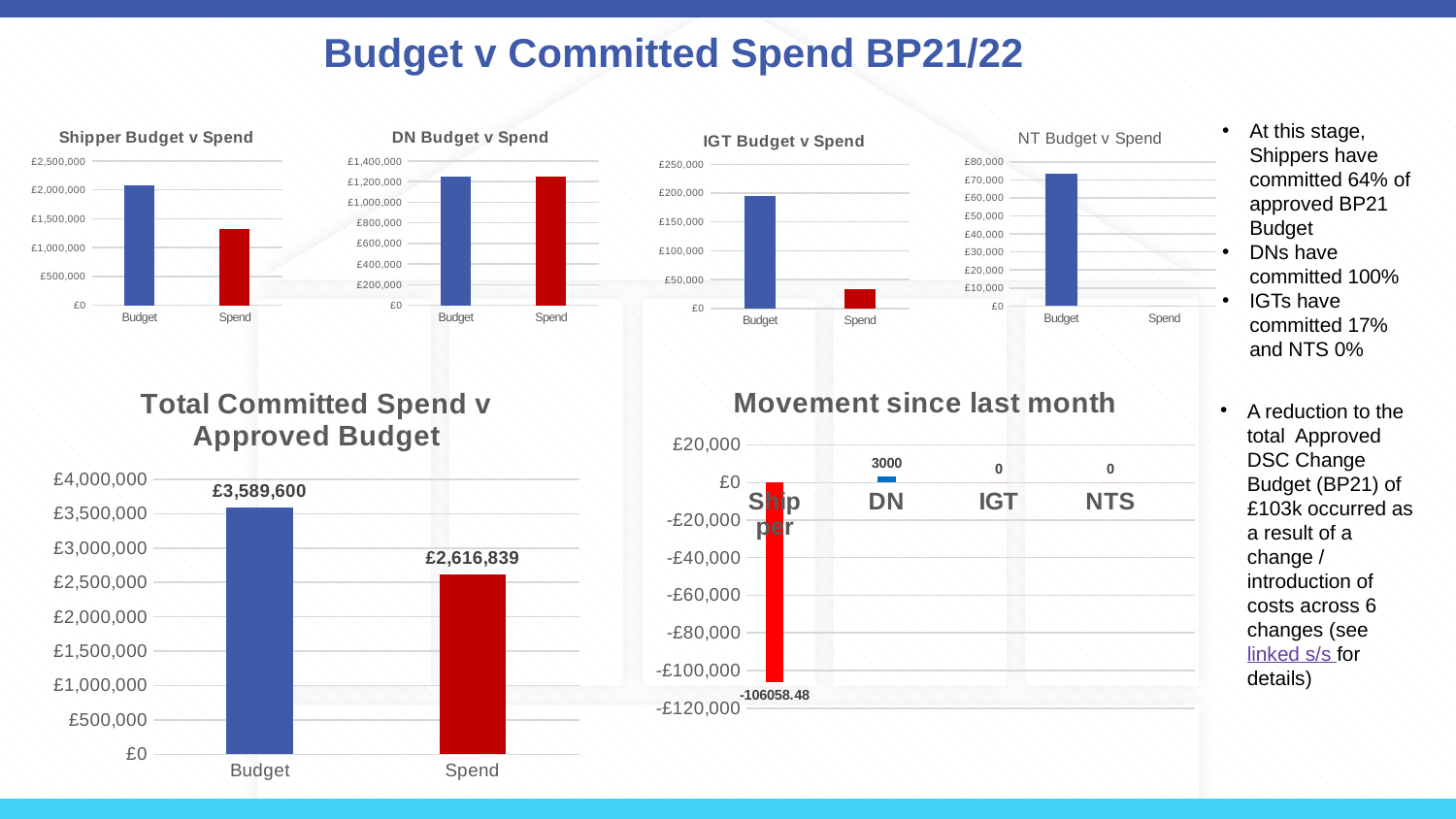
In the 'Movement since last month' chart, how many categories are shown on the x axis? 4 In the 'Movement since last month' chart, what is the value for Shipper? -106058.48 In the 'Total Committed Spend v Approved Budget' chart, what is the difference between Budget and Spend? £972,761 In the 'IGT Budget v Spend' chart, is the value for Spend greater or less than £50,000? less In the 'Movement since last month' chart, which category has the lowest value? Shipper In the 'Total Committed Spend v Approved Budget' chart, what is the value for Spend? £2,616,839 In the 'Shipper Budget v Spend' chart, is the value for Budget greater or less than £1,500,000? greater In the 'Movement since last month' chart, what is the value for DN? 3000 In the 'NT Budget v Spend' chart, which is larger, Budget or Spend? Budget In the 'Total Committed Spend v Approved Budget' chart, what is the value for Budget? £3,589,600 What kind of chart is the 'DN Budget v Spend' chart? Bar chart In the 'IGT Budget v Spend' chart, is the value for Budget greater or less than £150,000? greater